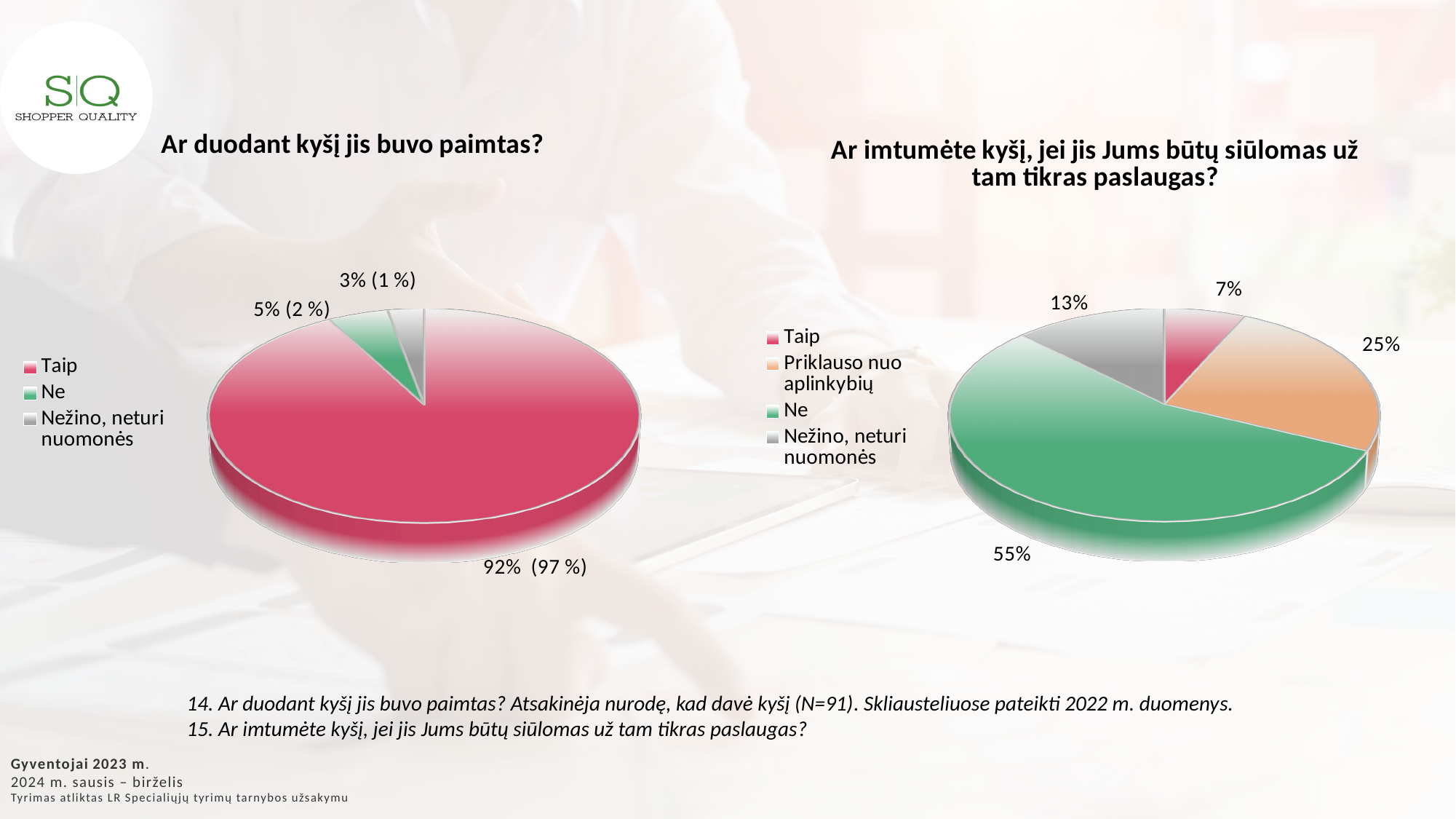
In the chart titled "Ar duodant kyšį jis buvo paimtas?", which category has the smallest slice? Nežino, neturi nuomonės In the chart titled "Ar duodant kyšį jis buvo paimtas?", what share of the pie is "Nežino, neturi nuomonės"? 3% In the chart titled "Ar imtumėte kyšį, jei jis Jums būtų siūlomas už tam tikras paslaugas?", what share of the pie is "Ne"? 55% In the chart titled "Ar imtumėte kyšį, jei jis Jums būtų siūlomas už tam tikras paslaugas?", which category has the largest slice? Ne In the chart titled "Ar duodant kyšį jis buvo paimtas?", how many categories does the legend list? 3 In the chart titled "Ar imtumėte kyšį, jei jis Jums būtų siūlomas už tam tikras paslaugas?", what share of the pie is "Priklauso nuo aplinkybių"? 25% In the chart titled "Ar imtumėte kyšį, jei jis Jums būtų siūlomas už tam tikras paslaugas?", how many categories does the legend list? 4 In the chart titled "Ar imtumėte kyšį, jei jis Jums būtų siūlomas už tam tikras paslaugas?", which category has the smallest slice? Taip In the chart titled "Ar imtumėte kyšį, jei jis Jums būtų siūlomas už tam tikras paslaugas?", what is the difference in percentage points between "Ne" and "Priklauso nuo aplinkybių"? 30 What type of chart is used on the right side of the slide? Pie chart In the chart titled "Ar duodant kyšį jis buvo paimtas?", what is the value shown in parentheses for "Ne"? 2 %